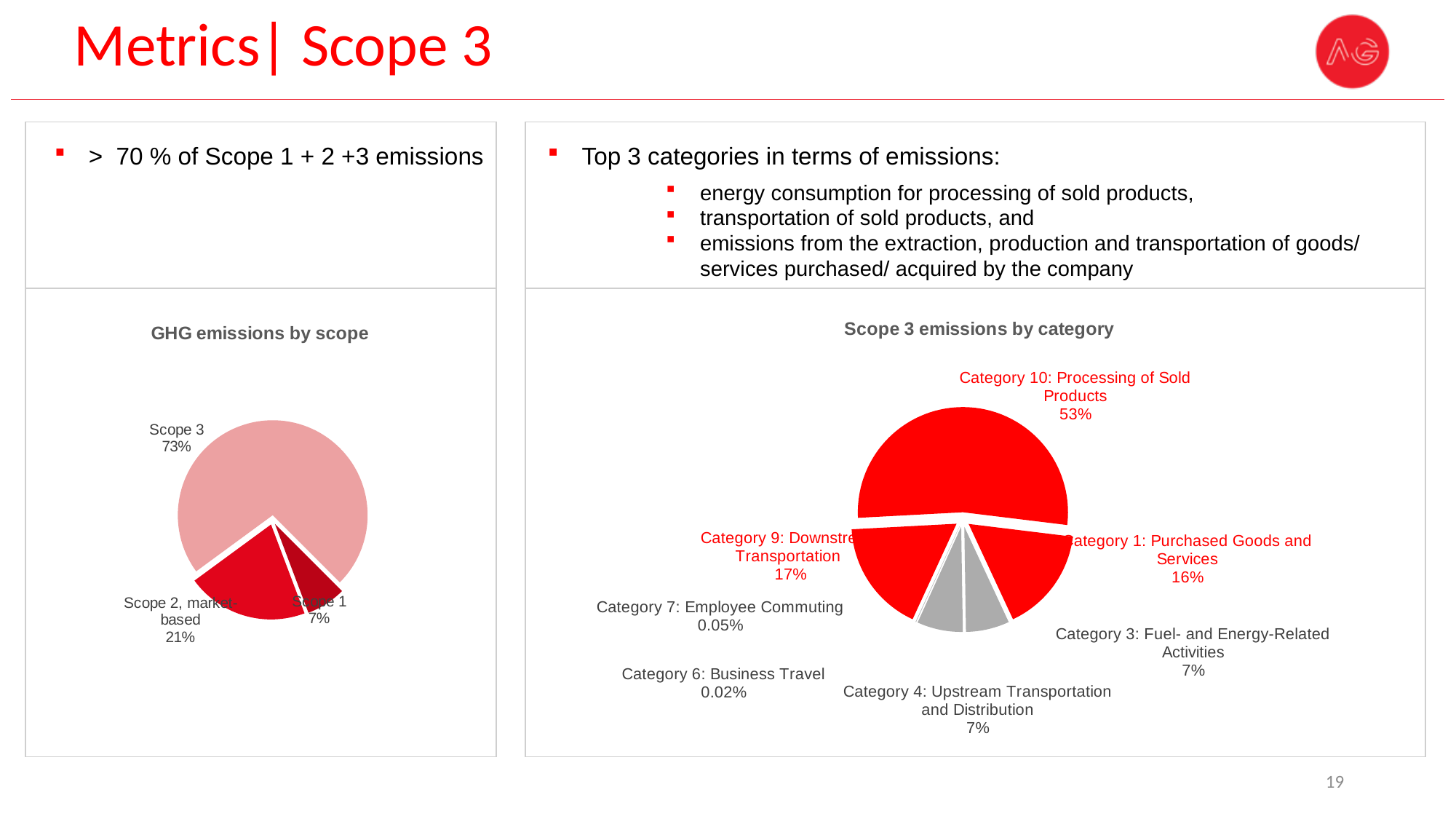
In the 'GHG emissions by scope' chart, what share of emissions is Scope 3? 73% In the 'GHG emissions by scope' chart, what share of emissions is Scope 2, market-based? 21% In the 'Scope 3 emissions by category' chart, what share is Category 1: Purchased Goods and Services? 16% In the 'GHG emissions by scope' chart, what is the difference in percentage points between Scope 3 and Scope 2, market-based? 52 In the 'Scope 3 emissions by category' chart, which category has the smallest share? Category 6: Business Travel How many categories are shown in the 'Scope 3 emissions by category' chart? 7 In the 'Scope 3 emissions by category' chart, which is larger: Category 9: Downstream Transportation or Category 3: Fuel- and Energy-Related Activities? Category 9: Downstream Transportation In the 'GHG emissions by scope' chart, which scope has the smallest share? Scope 1 How many slices does the 'GHG emissions by scope' chart have? 3 What kind of chart is 'GHG emissions by scope'? Pie chart